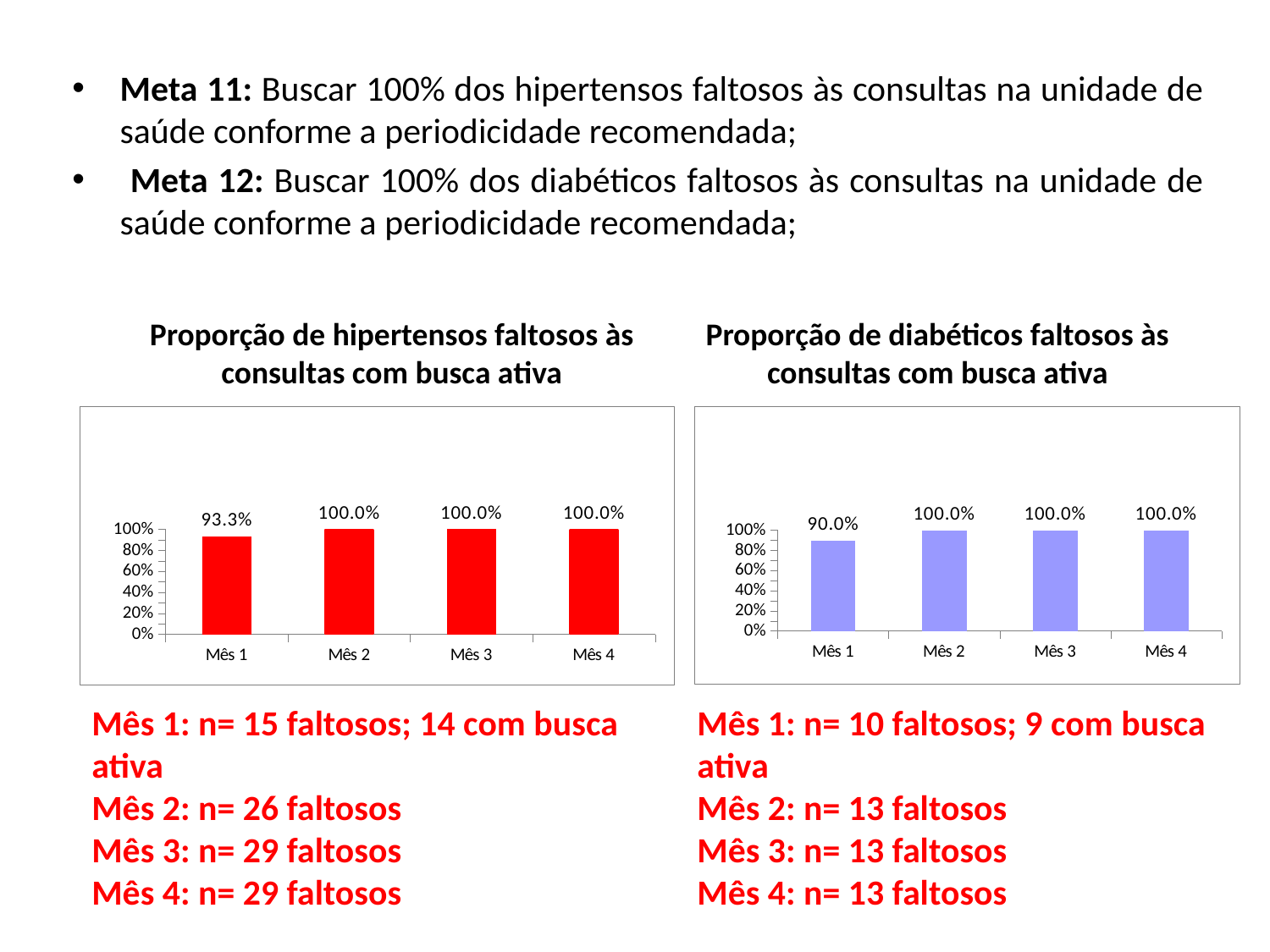
In the chart 'Proporção de hipertensos faltosos às consultas com busca ativa', do the values rise or fall from Mês 1 to Mês 2? Rise What kind of chart is 'Proporção de diabéticos faltosos às consultas com busca ativa'? Bar chart In the chart 'Proporção de diabéticos faltosos às consultas com busca ativa', what is the value for Mês 1? 90.0% In the chart 'Proporção de diabéticos faltosos às consultas com busca ativa', is the value for Mês 1 greater or less than 80%? greater In the chart 'Proporção de hipertensos faltosos às consultas com busca ativa', what is the value for Mês 1? 93.3% In the chart 'Proporção de hipertensos faltosos às consultas com busca ativa', what is the value for Mês 3? 100.0% In the chart 'Proporção de diabéticos faltosos às consultas com busca ativa', what is the value for Mês 4? 100.0% In the chart 'Proporção de hipertensos faltosos às consultas com busca ativa', which month has the lowest value? Mês 1 In the chart 'Proporção de diabéticos faltosos às consultas com busca ativa', what is the difference between the values for Mês 2 and Mês 1? 10.0% How many months are shown in the chart 'Proporção de hipertensos faltosos às consultas com busca ativa'? 4 In the chart 'Proporção de diabéticos faltosos às consultas com busca ativa', which month has the lowest value? Mês 1 In the chart 'Proporção de hipertensos faltosos às consultas com busca ativa', what is the difference between the values for Mês 2 and Mês 1? 6.7%